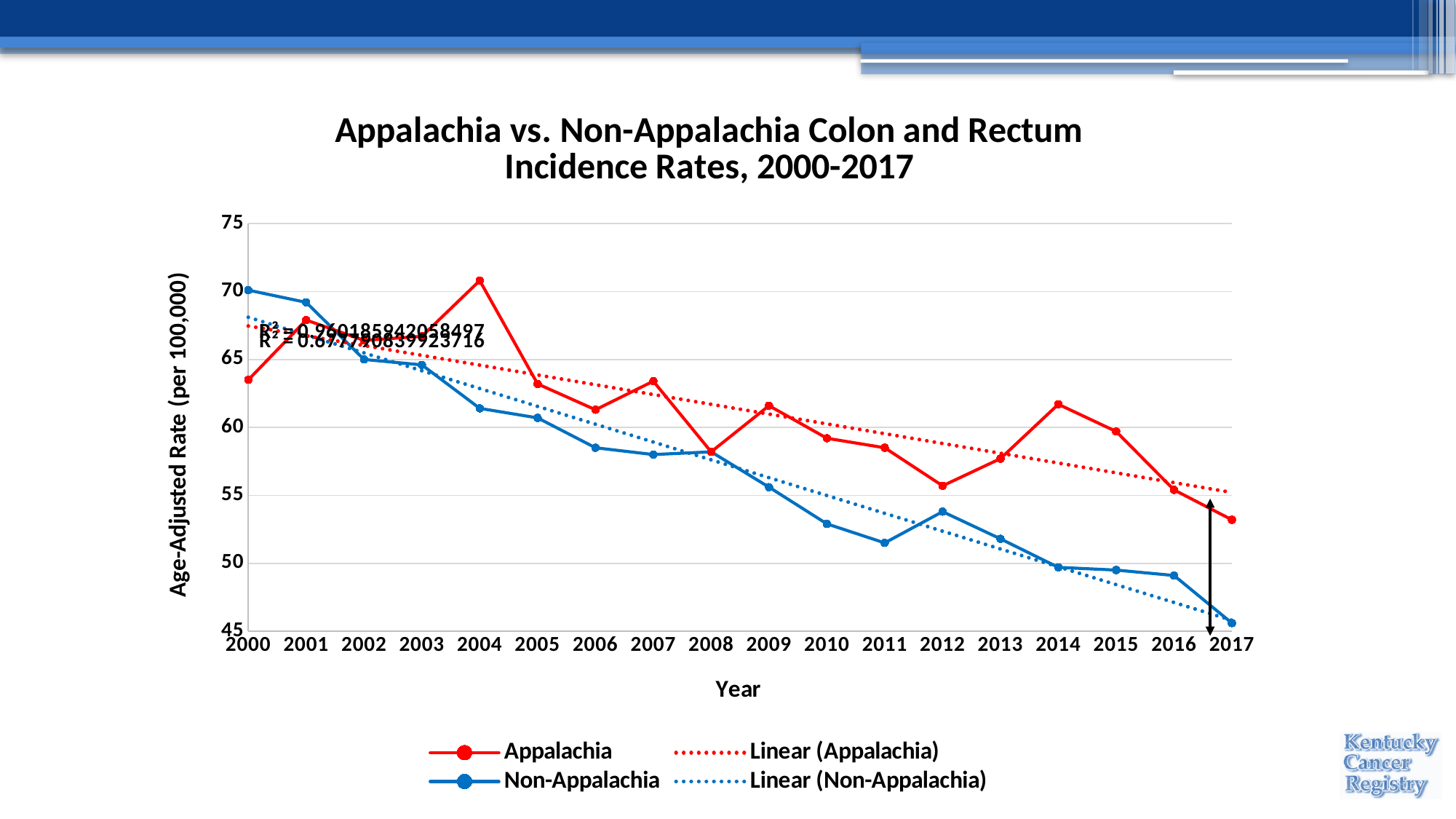
In which year does the Non-Appalachia series reach its lowest value? 2017 What is the label of the y axis? Age-Adjusted Rate (per 100,000) In 2000, which series has the higher value, Appalachia or Non-Appalachia? Non-Appalachia Do the Non-Appalachia incidence rates generally rise or fall from 2000 to 2017? Fall How many years are plotted along the x axis? 18 In which year does the Appalachia series reach its highest value? 2004 Is the Non-Appalachia value for 2017 greater or less than 50? less Do the Appalachia incidence rates generally rise or fall from 2000 to 2017? Fall What kind of chart is shown on the slide? Line chart In 2017, which series has the higher value, Appalachia or Non-Appalachia? Appalachia Is the Appalachia value for 2004 greater or less than 65? greater How many entries does the chart legend list? 4